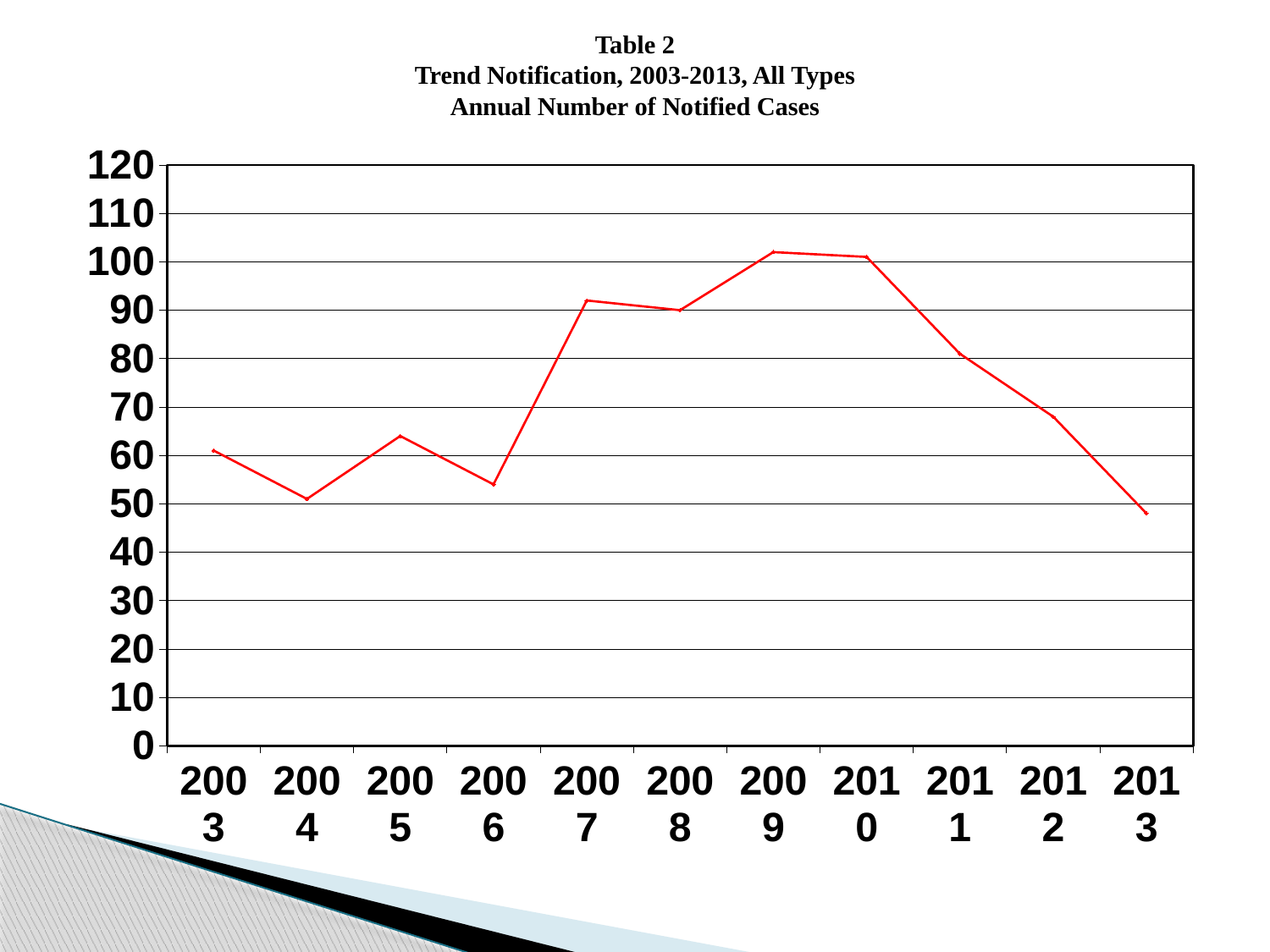
Which year has the larger value, 2005 or 2006? 2005 Is the value for 2009 greater or less than 100? greater Which year has the lowest number of notified cases? 2013 Is the value for 2007 greater or less than 80? greater Is the value for 2006 greater or less than 60? less Do the values rise or fall from 2010 to 2013? fall What colour is the plotted line? red Which year has the larger value, 2011 or 2012? 2011 What kind of chart is shown on the slide? line chart How many years are plotted on the x axis? 11